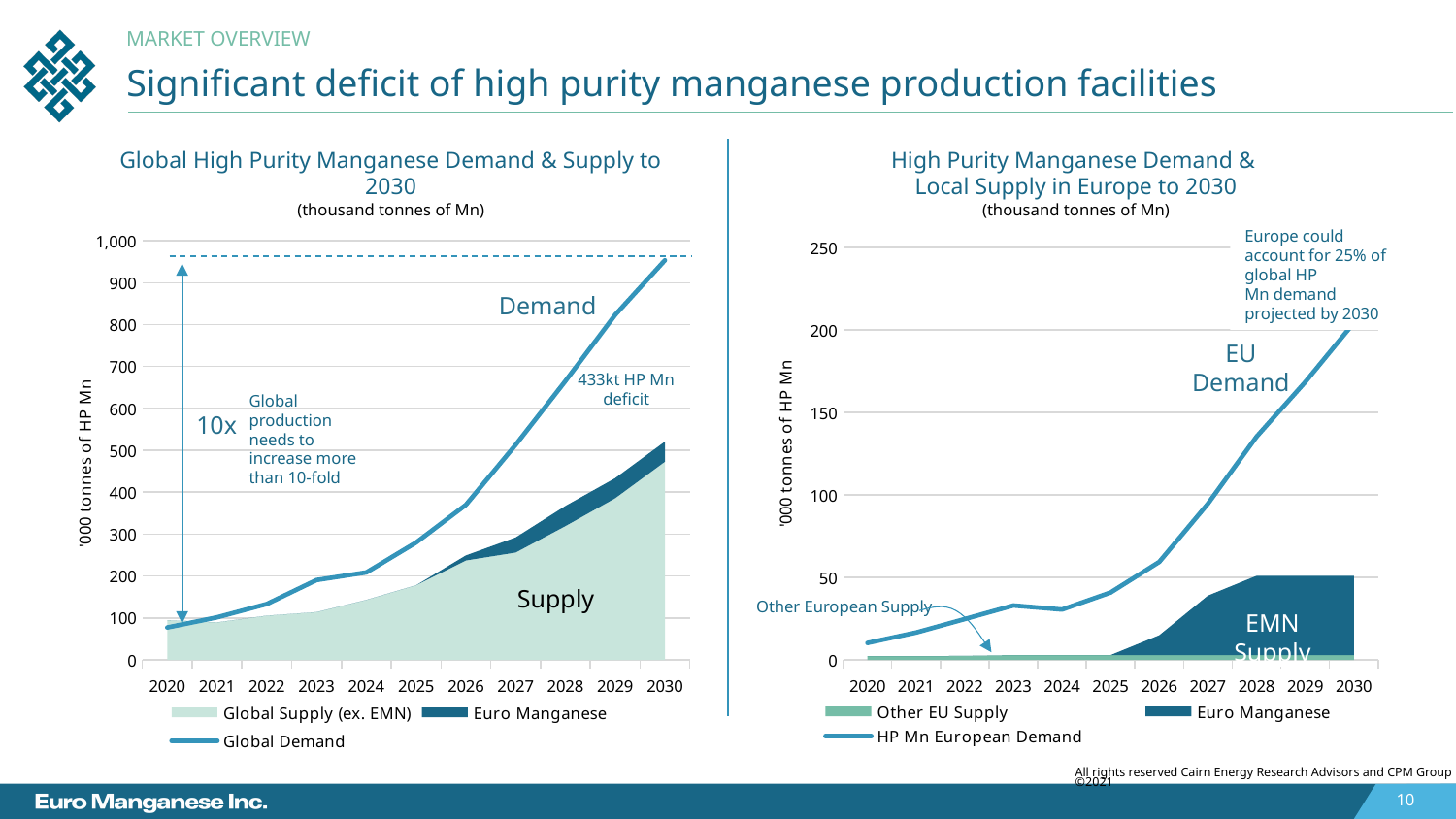
On the right chart, 'High Purity Manganese Demand & Local Supply in Europe to 2030', how many series does the legend list? 3 On the left chart, how many years are shown on the x axis? 11 On the left chart, does Global Demand rise or fall from 2020 to 2030? rise On the right chart, which is larger in 2030: HP Mn European Demand or Euro Manganese supply? HP Mn European Demand On the right chart, does HP Mn European Demand rise or fall from 2025 to 2030? rise What unit is given in the subtitle of the left chart? thousand tonnes of Mn On the left chart, what HP Mn deficit is annotated for 2030? 433kt On the left chart, is the Global Demand value for 2030 greater or less than 900? greater On the right chart, is the HP Mn European Demand value for 2020 greater or less than 50? less On the right chart, is the HP Mn European Demand value for 2030 greater or less than 150? greater On the left chart, 'Global High Purity Manganese Demand & Supply to 2030', how many series does the legend list? 3